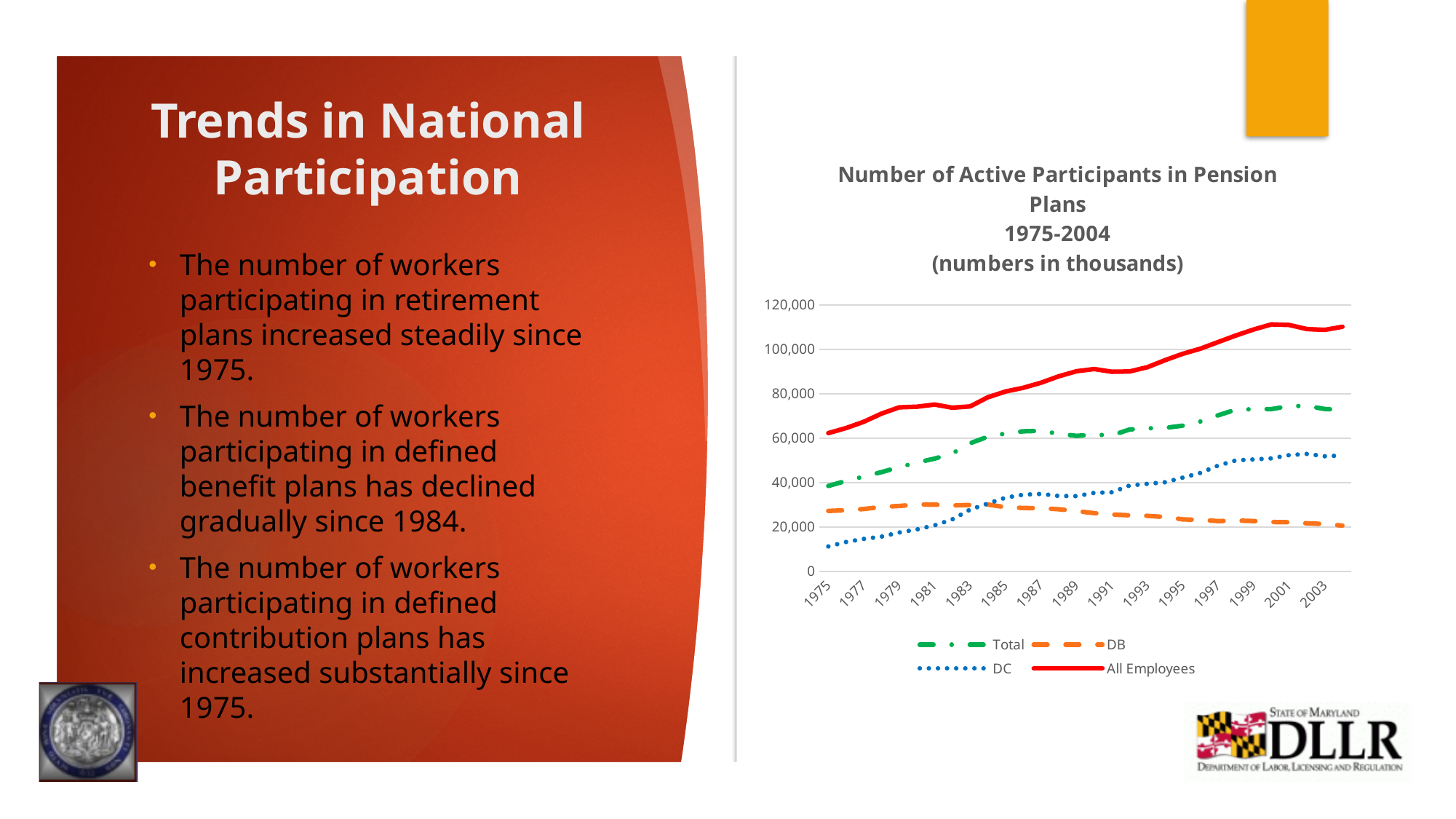
How many series does the legend of the chart list? 4 Does the DC series rise or fall from 1975 to 2003? rise In 2003, which series is larger, DC or DB? DC Which series has the highest values throughout the chart? All Employees What is the title of the chart? Number of Active Participants in Pension Plans 1975-2004 (numbers in thousands) In 1975, which series is larger, DB or DC? DB Which series has the lowest value in 2003? DB Does the DB series rise or fall from 1985 to 2003? fall Is the value for DC in 1975 greater or less than 20,000? less Which series is drawn as a solid red line in the chart? All Employees What kind of chart is shown on the slide? line chart Is the value for All Employees in 2001 greater or less than 100,000? greater